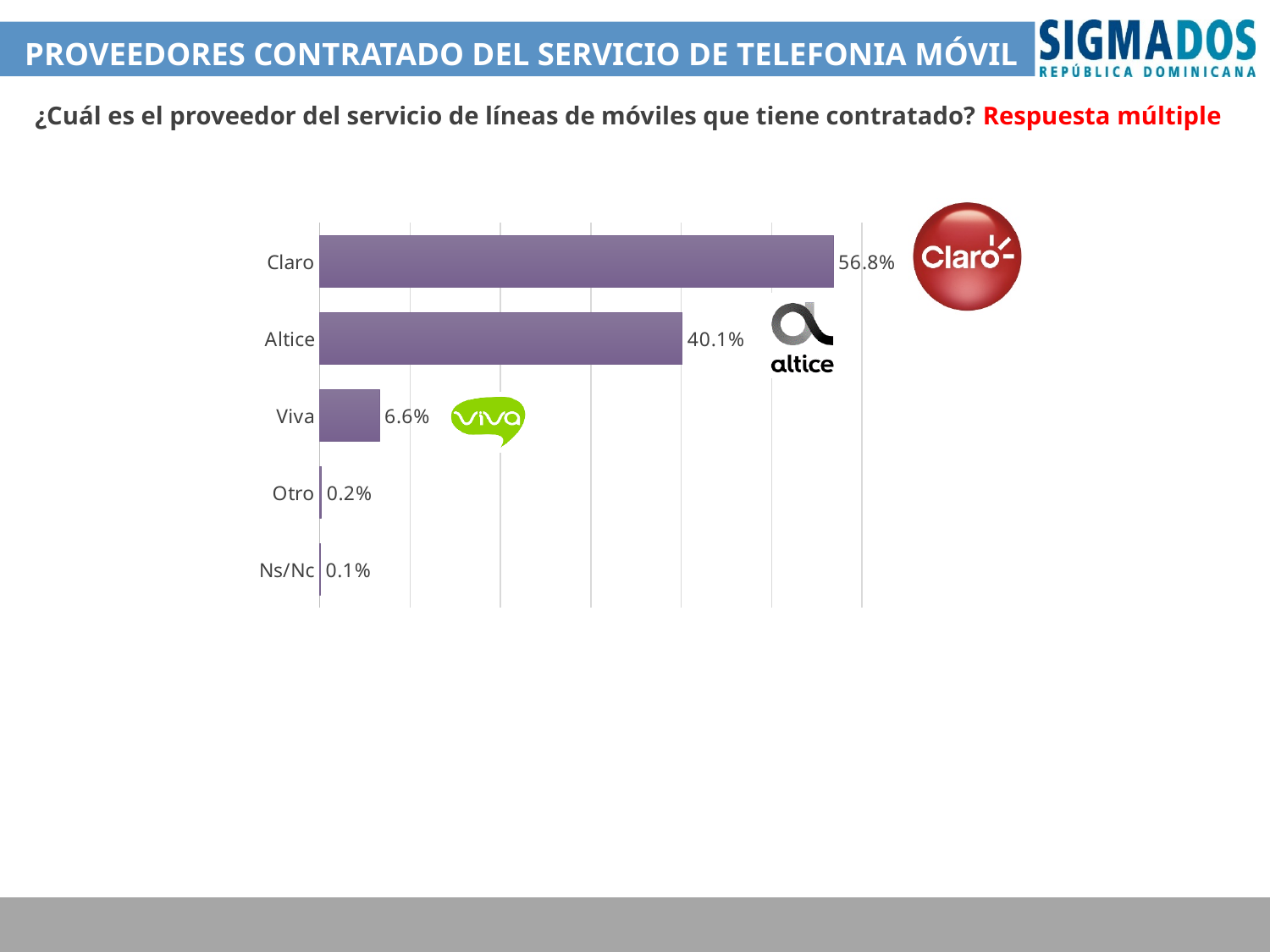
Which category has the lowest value? Ns/Nc What is the value for Otro? 0.2% What is the value for Claro? 56.8% What is the difference between the values for Claro and Altice? 16.7% What is the value for Ns/Nc? 0.1% Which is larger, the value for Altice or the value for Viva? Altice What is the value for Viva? 6.6% What kind of chart is shown on the slide? Bar chart What is the value for Altice? 40.1% What is the difference between the values for Viva and Otro? 6.4% Which category has the highest value? Claro How many categories are shown in the chart? 5